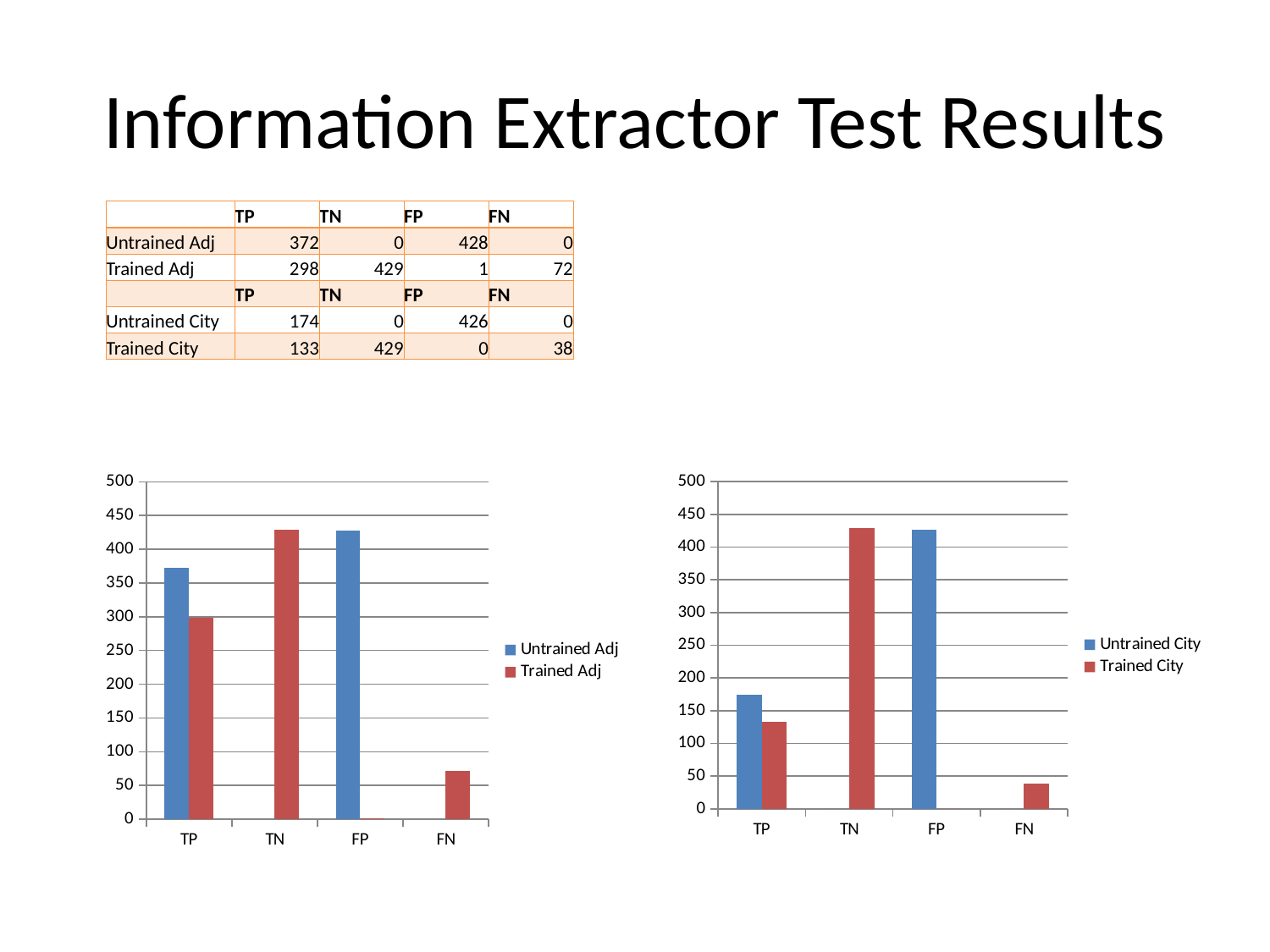
How many series does the legend of the right chart list? 2 In the left chart, which is larger for TP: Untrained Adj or Trained Adj? Untrained Adj How many categories are shown on the x axis of the left chart? 4 What is the difference between the Untrained Adj and Trained Adj values for TP in the left chart? 74 What kind of chart is the left chart on the slide? bar chart In the right chart, is the Trained City value for FN greater or less than 50? less In the left chart, which category has the highest Untrained Adj bar? FP What is the Trained Adj value for TN shown in the left chart? 429 In the right chart, which category has the highest Trained City bar? TN In the left chart, is the Untrained Adj value for TP greater or less than 350? greater What is the Untrained City value for FP shown in the right chart? 426 In the right chart, which is larger for TP: Untrained City or Trained City? Untrained City